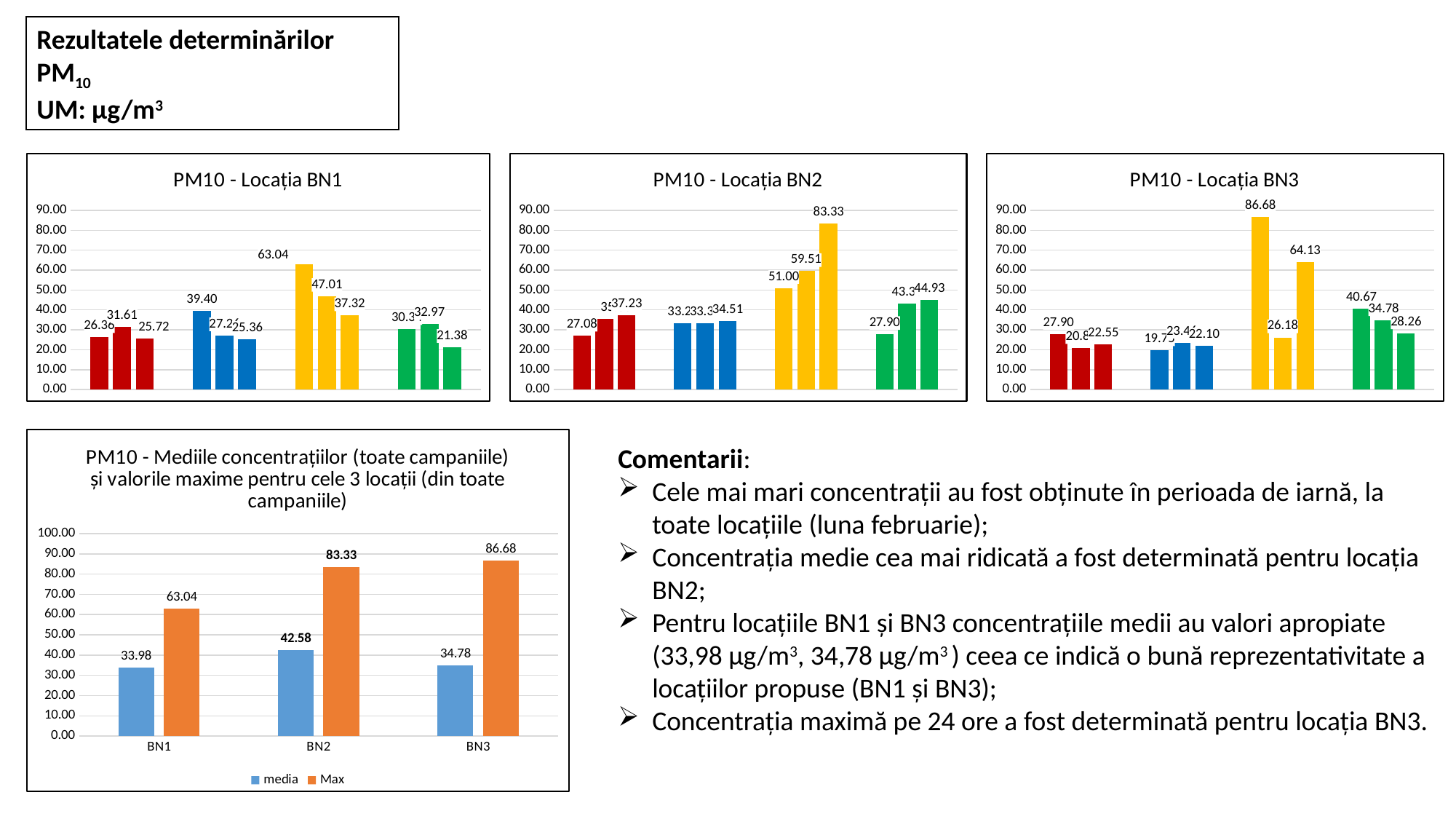
In the chart 'PM10 - Locația BN1', what is the highest value shown? 63.04 In the chart 'PM10 - Locația BN2', what is the highest value shown? 83.33 In the bottom-left chart 'PM10 - Mediile concentrațiilor', which location has the highest 'media' value? BN2 In the bottom-left chart 'PM10 - Mediile concentrațiilor', what is the 'Max' value for BN1? 63.04 In the bottom-left chart 'PM10 - Mediile concentrațiilor', how many series does the legend list? 2 What kind of chart is 'PM10 - Locația BN1'? Bar chart In the bottom-left chart 'PM10 - Mediile concentrațiilor', what is the 'media' value for BN2? 42.58 In the bottom-left chart 'PM10 - Mediile concentrațiilor', what is the 'Max' value for BN3? 86.68 In the bottom-left chart 'PM10 - Mediile concentrațiilor', what is the difference between the 'Max' and 'media' values for BN2? 40.75 In the chart 'PM10 - Locația BN3', is the highest bar greater or less than 80? greater In the bottom-left chart 'PM10 - Mediile concentrațiilor', how many locations are shown on the x axis? 3